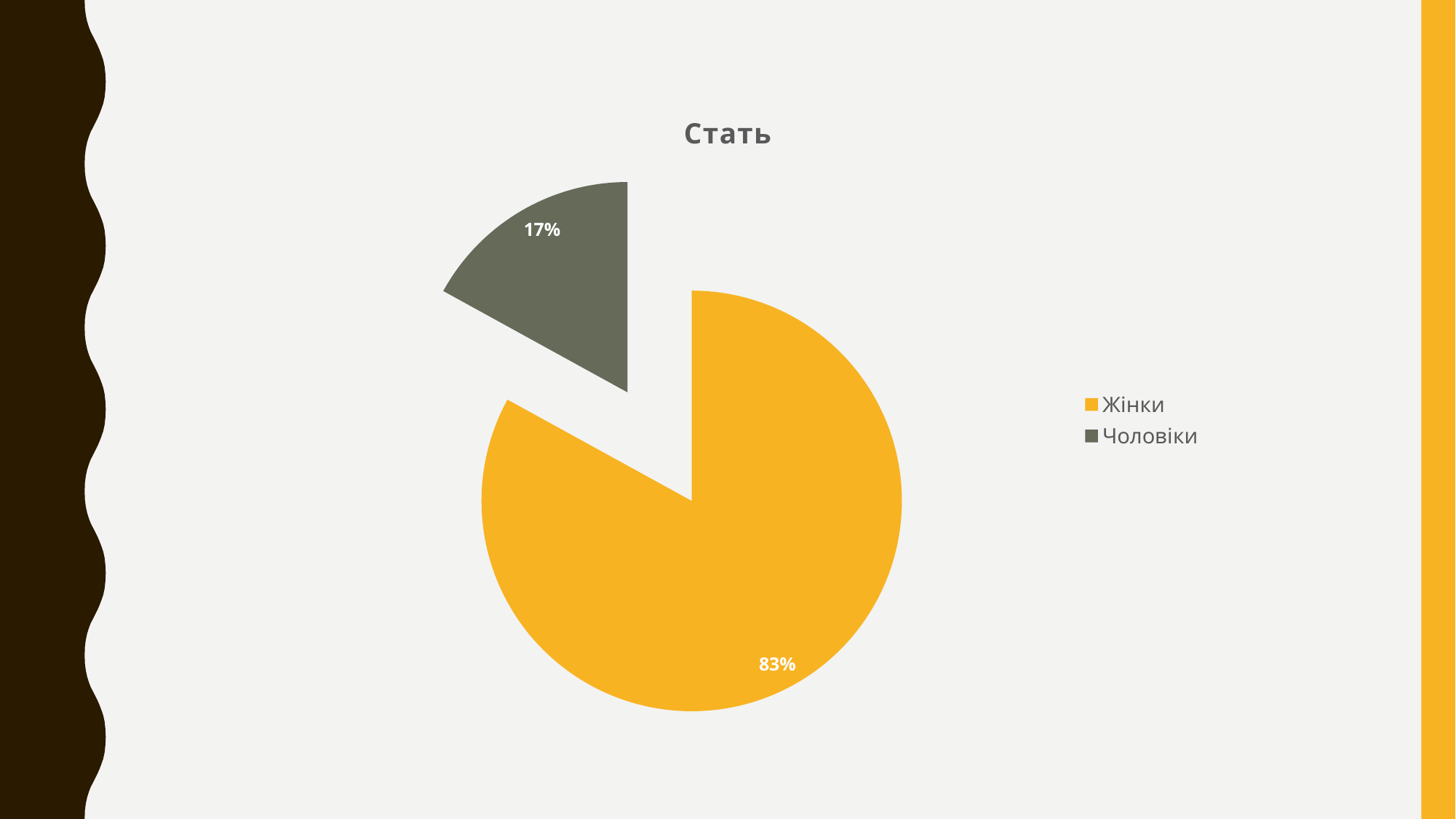
Which category has the smallest slice of the pie? Чоловіки What colour is the slice for Чоловіки? grey What share of the pie does Чоловіки take? 17% Which category has the largest slice of the pie? Жінки Which is larger, the slice for Жінки or the slice for Чоловіки? Жінки What is the difference in percentage points between the Жінки slice and the Чоловіки slice? 66 What kind of chart is shown on the slide? pie chart How many slices does the pie chart have? 2 What share of the pie does Жінки take? 83% What is the title of the chart? Стать How many entries does the legend list? 2